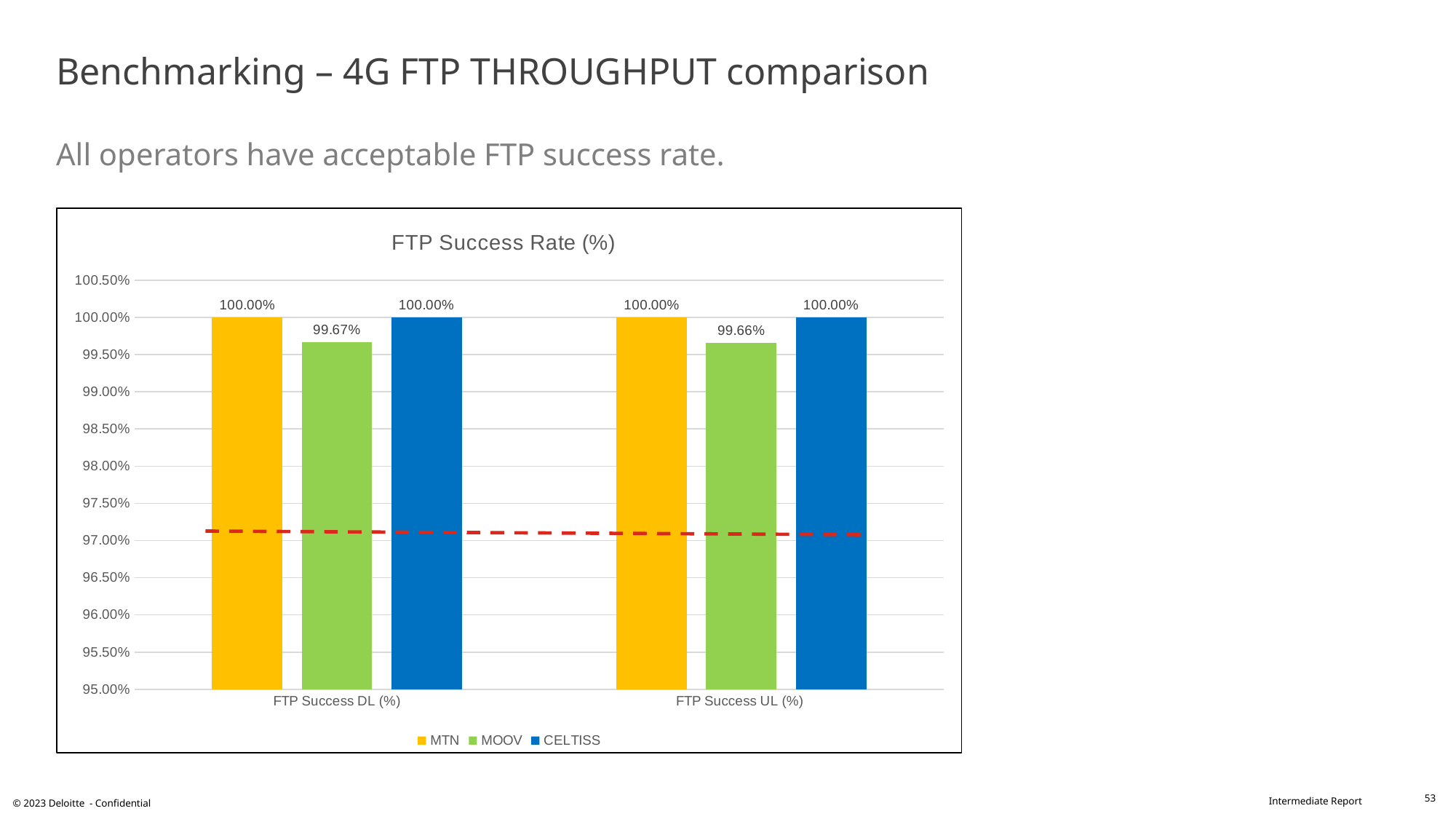
Is the FTP Success DL (%) value for MOOV greater or less than 99.50%? greater Which operator has the lowest FTP Success UL (%)? MOOV What is the FTP Success DL (%) value for MTN? 100.00% What is the FTP Success UL (%) value for MOOV? 99.66% What type of chart is shown on the slide? Bar chart How many series does the legend list? 3 What is the FTP Success UL (%) value for CELTISS? 100.00% How many categories are shown on the x axis? 2 What is the FTP Success DL (%) value for MOOV? 99.67% What is the difference between MTN and MOOV for FTP Success DL (%)? 0.33% What is the difference between CELTISS and MOOV for FTP Success UL (%)? 0.34% Which is larger, MOOV's FTP Success DL (%) or MOOV's FTP Success UL (%)? FTP Success DL (%)